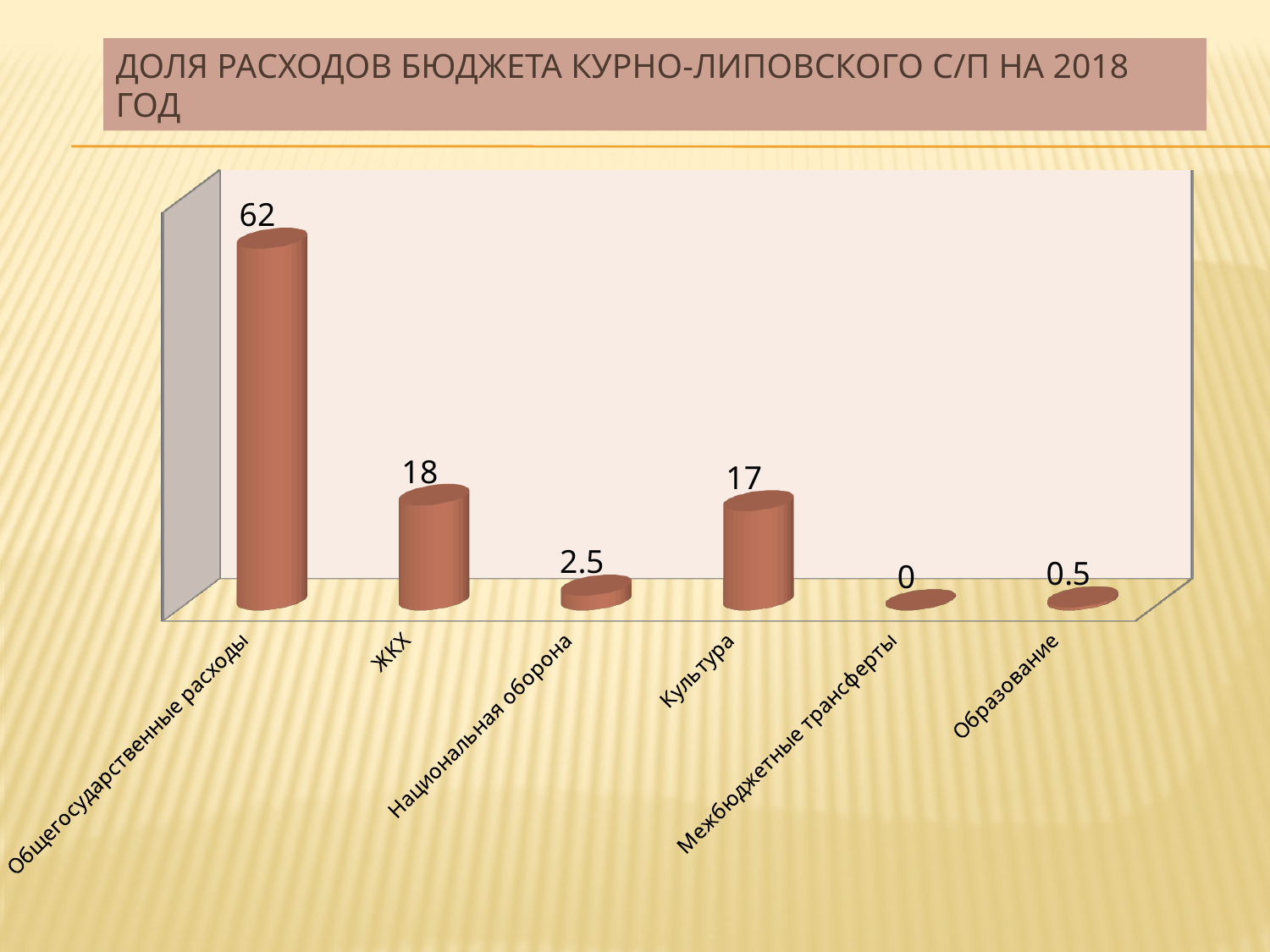
How many categories are shown on the chart? 6 What is the value for Общегосударственные расходы? 62 Which is larger, the value for ЖКХ or the value for Культура? ЖКХ Which category has the lowest value? Межбюджетные трансферты What is the value for Национальная оборона? 2.5 Which category has the highest value? Общегосударственные расходы What is the difference between the values for Общегосударственные расходы and ЖКХ? 44 What is the title of the slide? Доля расходов бюджета Курно-Липовского с/п на 2018 год What kind of chart is shown on the slide? Bar chart What is the value for ЖКХ? 18 What is the value for Культура? 17 What is the value for Образование? 0.5